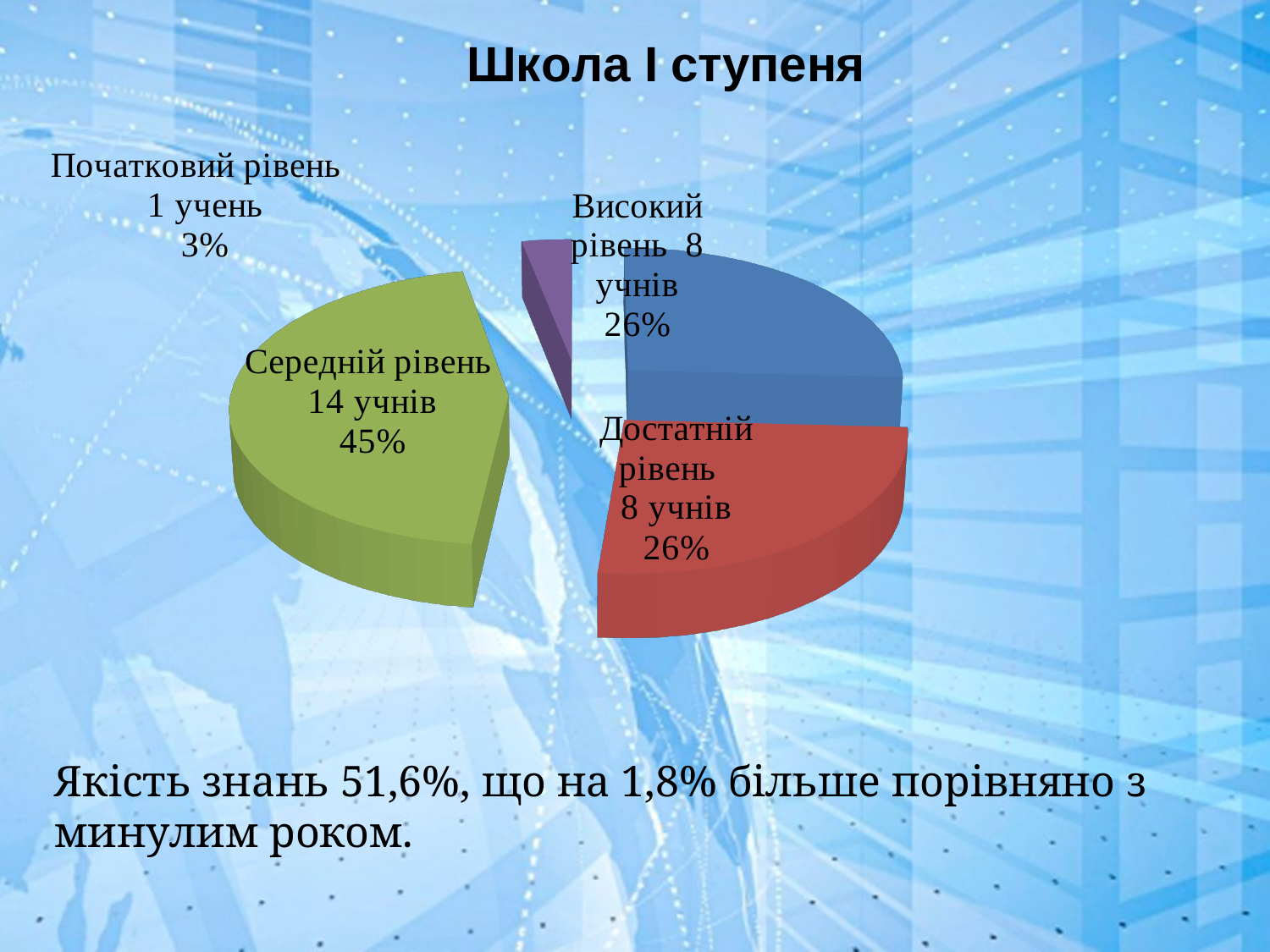
How many students are in the Середній рівень slice? 14 учнів Which is larger: the slice for Середній рівень or the slice for Високий рівень? Середній рівень Which level has the largest slice of the pie? Середній рівень What is the difference in students between Середній рівень and Достатній рівень? 6 Which level has the smallest slice of the pie? Початковий рівень What kind of chart is shown on the slide? pie chart What share of the pie does Середній рівень have? 45% How many students are in the Високий рівень slice? 8 учнів How many slices does the pie chart have? 4 What is the title of the slide containing the pie chart? Школа І ступеня What share of the pie does Достатній рівень have? 26% What share of the pie does Початковий рівень have? 3%